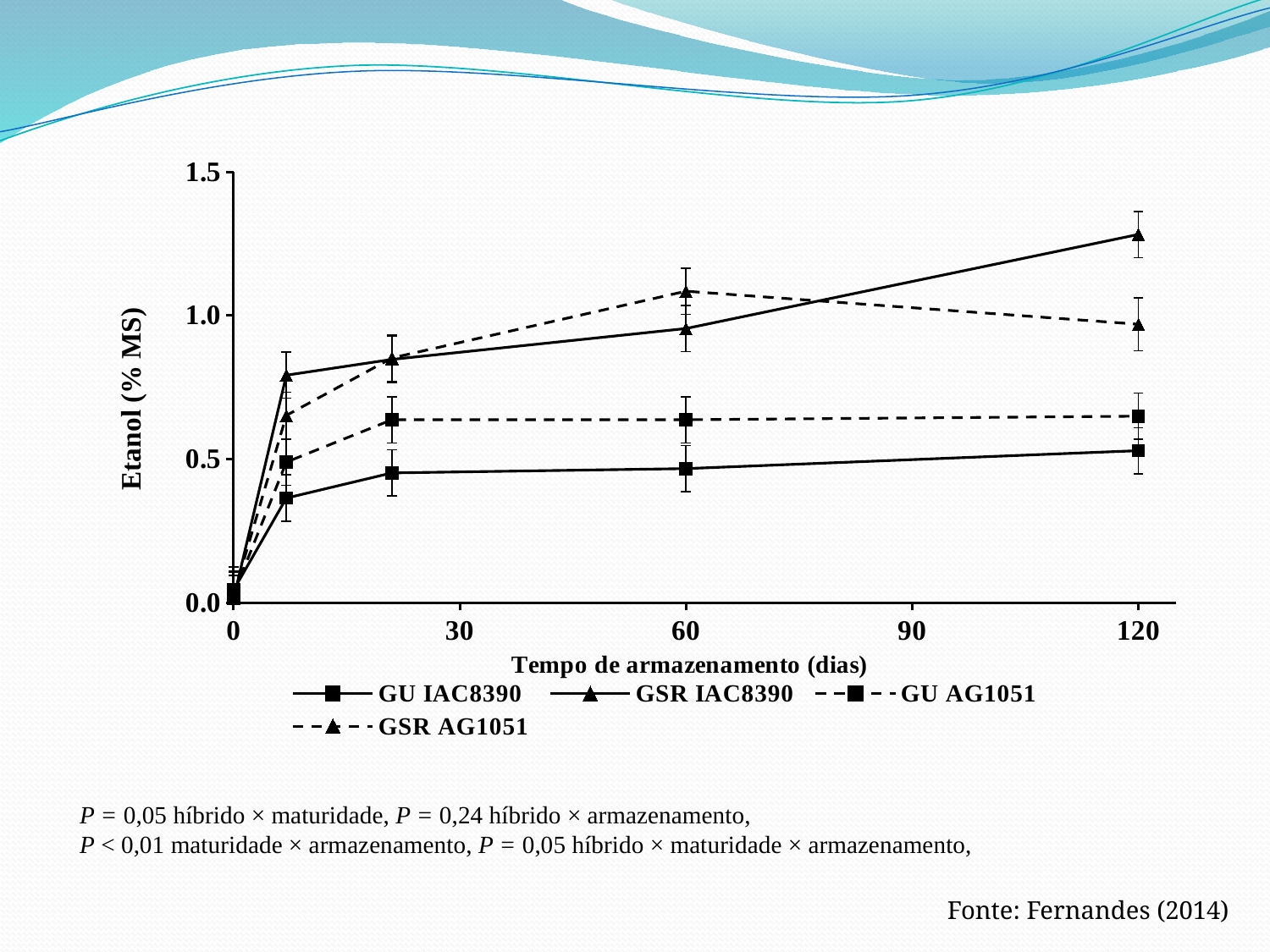
Is the value for GU AG1051 at 60 days greater or less than 0.5? greater Which series has the highest value at 120 days? GSR IAC8390 Is the value for GSR IAC8390 at 120 days greater or less than 1.0? greater At 60 days, which is larger: GSR AG1051 or GSR IAC8390? GSR AG1051 What kind of chart is shown on the slide? line chart How many data points are plotted for each series? 5 Does the GSR IAC8390 series rise or fall from 0 to 120 days? rise What is the title of the x axis? Tempo de armazenamento (dias) What is the title of the y axis? Etanol (% MS) How many series does the legend list? 4 Is the value for GU IAC8390 at 120 days greater or less than 1.0? less Which series has the lowest value at 120 days? GU IAC8390